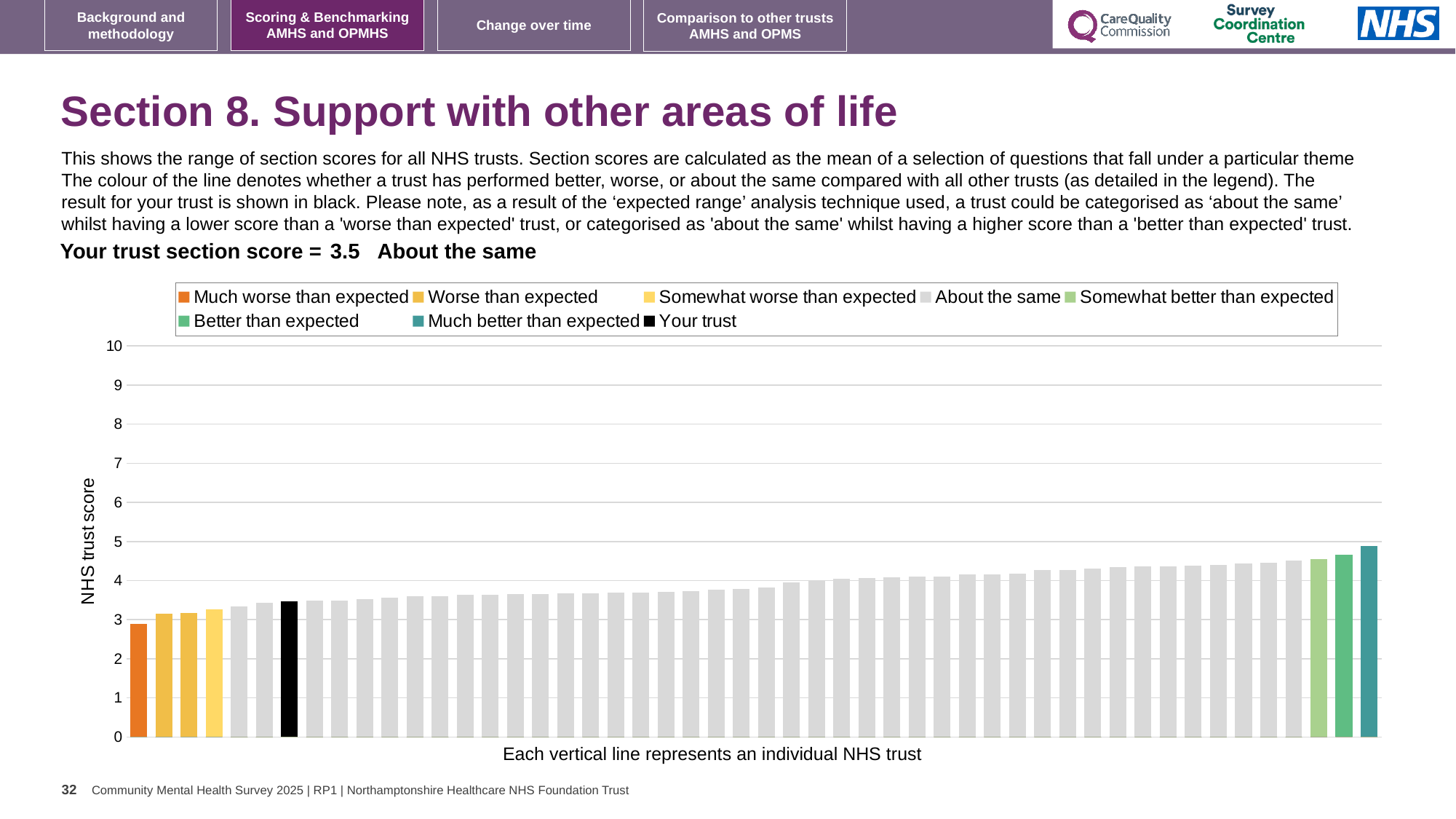
Is the value of the tallest bar (the rightmost, 'Much better than expected' trust) greater or less than 5? less Which is larger: the value of the black 'Your trust' bar or the value of the orange 'Much worse than expected' bar? Your trust Is the value of the shortest bar (the leftmost trust) greater or less than 2? greater Do the bar values rise or fall from left to right along the x axis? rise What is the section score for your trust, as printed on the slide? 3.5 What kind of chart is shown on the slide? bar chart How many entries does the chart legend list? 8 Is the value of the shortest bar (the leftmost, 'Much worse than expected' trust) greater or less than 3? less Which category does your trust fall into according to the text above the chart? About the same What colour is the bar representing your trust? black What is the label of the y axis? NHS trust score